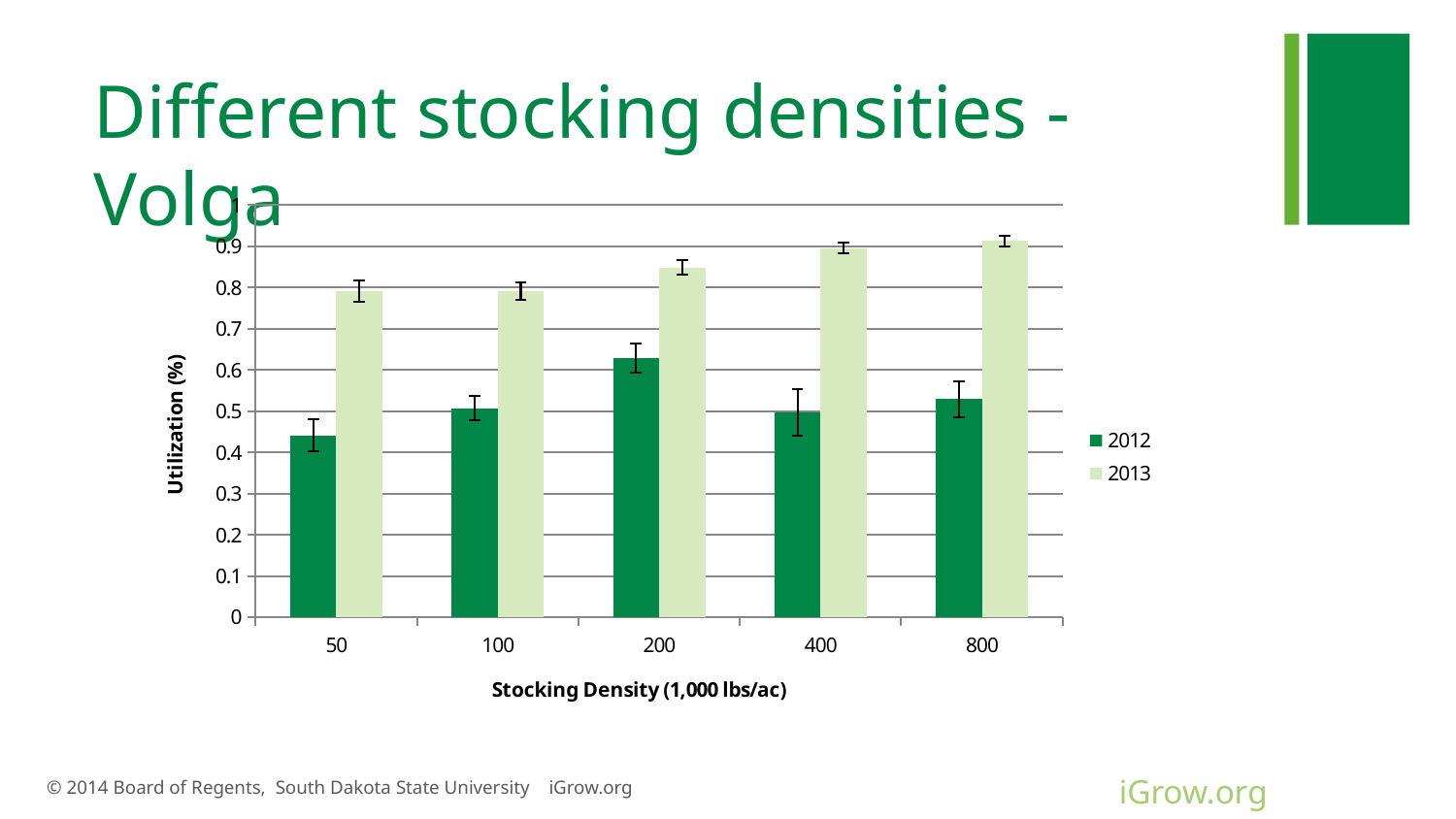
How many stocking density categories are shown on the x axis? 5 Is the 2012 utilization at a stocking density of 200 greater or less than 0.6? greater Which stocking density has the highest utilization for 2012? 200 Which stocking density has the lowest utilization for 2012? 50 At a stocking density of 50, which year has the higher utilization, 2012 or 2013? 2013 For 2012, is utilization higher at a stocking density of 200 or 400? 200 Is the 2012 utilization at a stocking density of 50 greater or less than 0.5? less What is the title of the x axis? Stocking Density (1,000 lbs/ac) How many series does the legend list? 2 Is the 2013 utilization at a stocking density of 400 greater or less than 0.8? greater Do the 2013 utilization values generally rise or fall as stocking density increases? rise What kind of chart is shown on the slide? bar chart